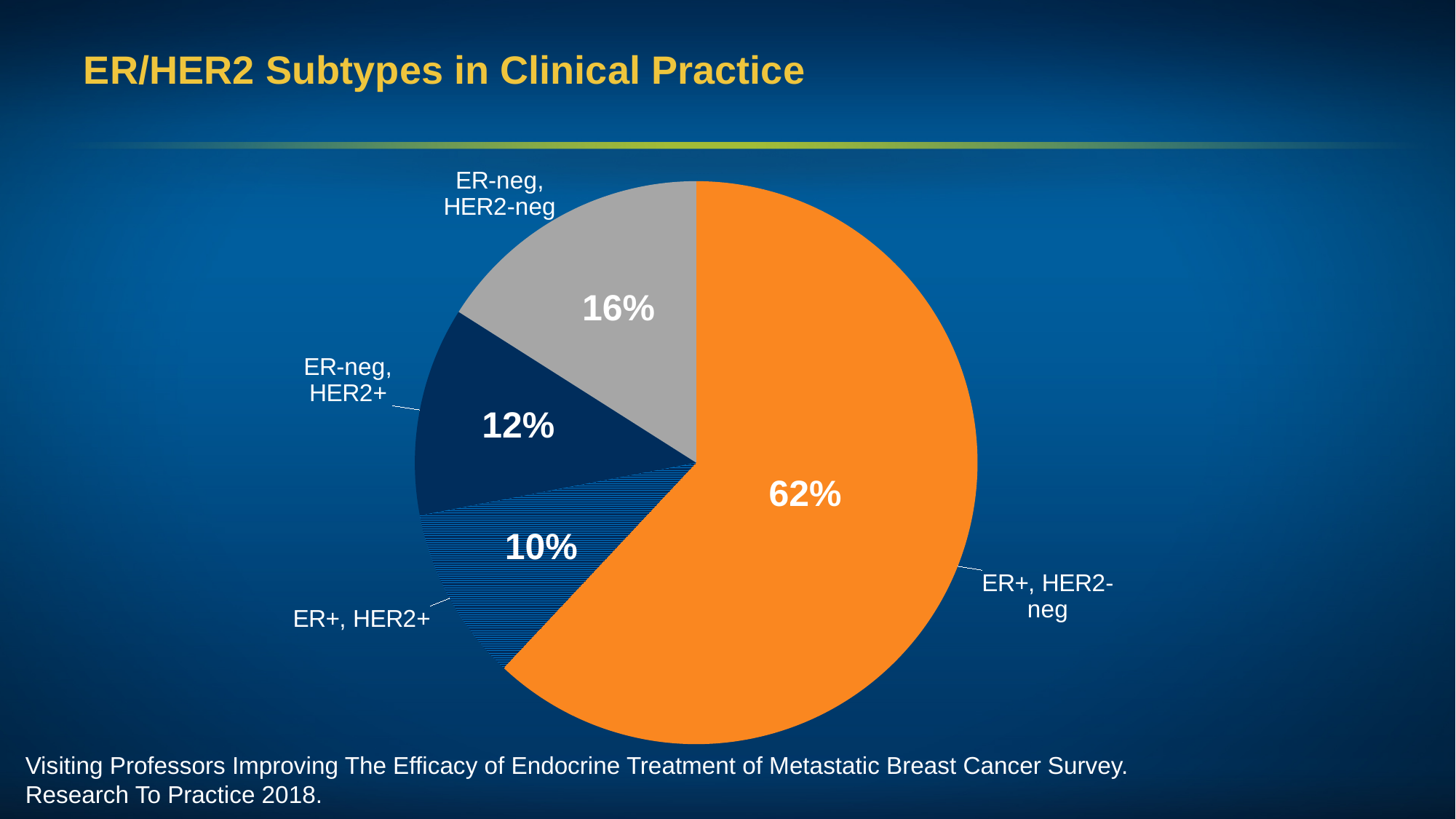
What is the difference in percentage points between ER-neg, HER2-neg and ER-neg, HER2+? 4 Which subtype has the smallest share of the pie? ER+, HER2+ How many slices does the pie chart have? 4 What is the title of the slide? ER/HER2 Subtypes in Clinical Practice What percentage of the pie is ER+, HER2+? 10% What is the difference in percentage points between ER+, HER2-neg and ER-neg, HER2-neg? 46 What kind of chart is shown on the slide? pie chart Which subtype has the largest share of the pie? ER+, HER2-neg What percentage of the pie is ER-neg, HER2+? 12% What percentage of the pie is ER-neg, HER2-neg? 16% Which is larger: the share for ER-neg, HER2+ or the share for ER+, HER2+? ER-neg, HER2+ What percentage of the pie is ER+, HER2-neg? 62%